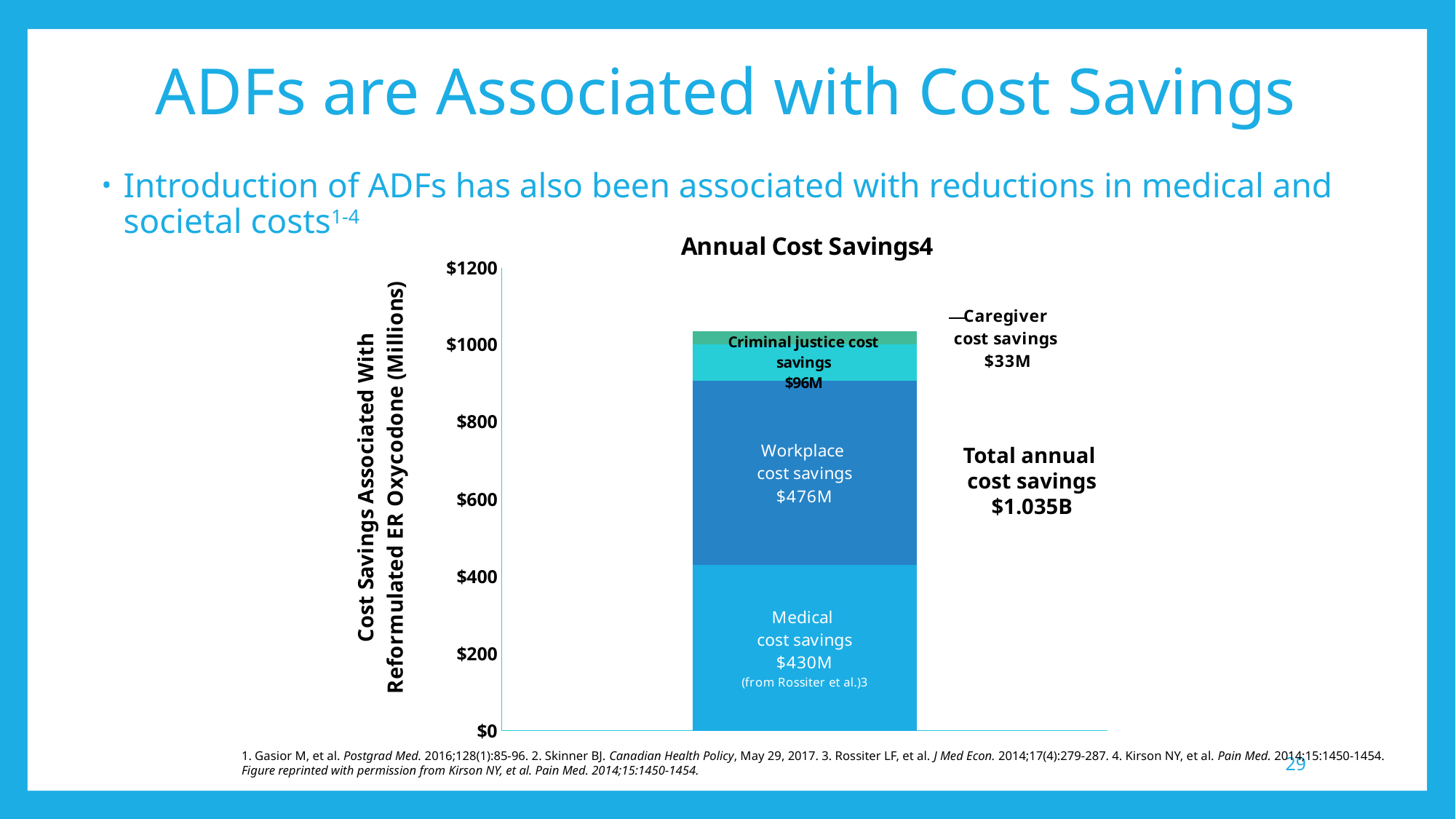
How much larger is the Workplace cost savings than the Medical cost savings? $46M What is the value of the Caregiver cost savings segment? $33M How many cost savings segments make up the stacked bar? 4 Which cost savings segment is the largest? Workplace cost savings Which cost savings segment is the smallest? Caregiver cost savings What is the total annual cost savings shown on the chart? $1.035B Which is larger, Criminal justice cost savings or Caregiver cost savings? Criminal justice cost savings What is the value of the Criminal justice cost savings segment? $96M What is the value of the Workplace cost savings segment? $476M What is the value of the Medical cost savings segment? $430M What is the label of the y-axis? Cost Savings Associated With Reformulated ER Oxycodone (Millions) What kind of chart is shown under the title "Annual Cost Savings4"? Stacked bar chart